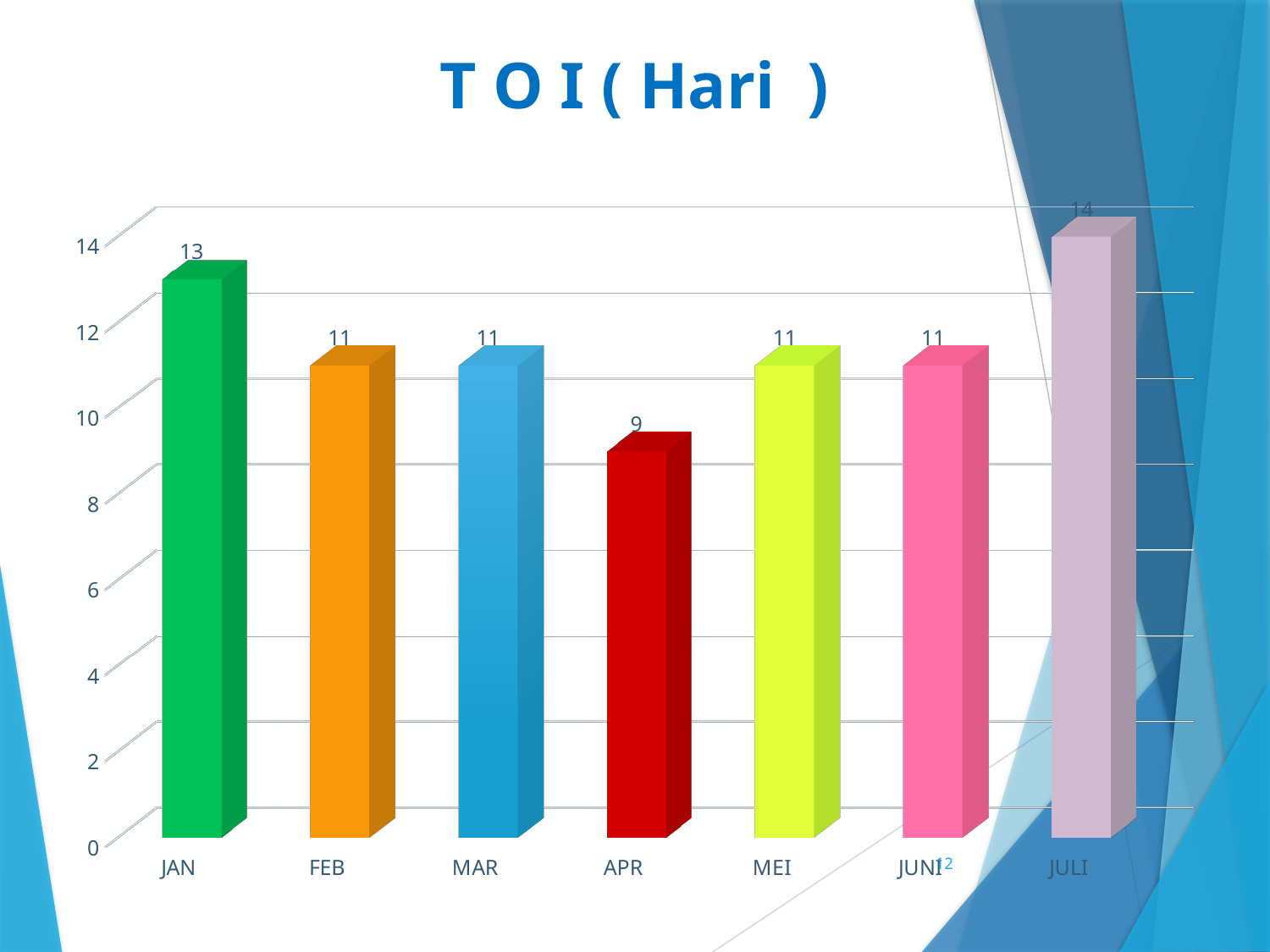
What is the difference between the values for JAN and FEB? 2 What is the title of the chart? T O I ( Hari ) What is the value for APR? 9 Which month has the lowest value? APR How many months are shown on the x axis? 7 What is the value for JAN? 13 What is the value for JULI? 14 Which is larger, the value for JAN or the value for MAR? JAN What is the value for FEB? 11 What kind of chart is shown on the slide? bar chart What is the difference between the values for JULI and APR? 5 Which month has the highest value? JULI